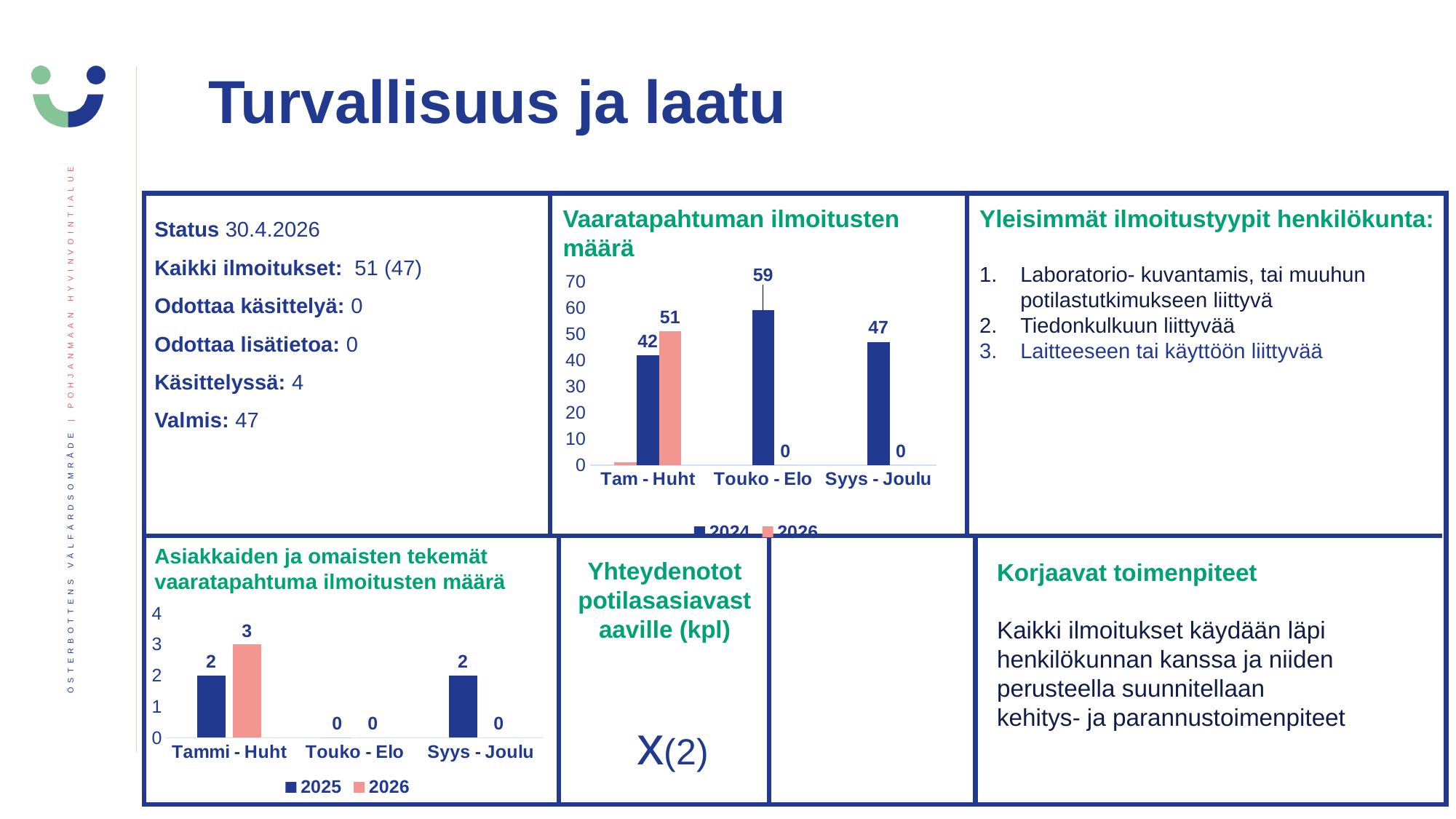
How many series does the legend of the chart 'Asiakkaiden ja omaisten tekemät vaaratapahtuma ilmoitusten määrä' list? 2 In the chart 'Asiakkaiden ja omaisten tekemät vaaratapahtuma ilmoitusten määrä', what is the 2025 value for Syys - Joulu? 2 What kind of chart is 'Vaaratapahtuman ilmoitusten määrä'? Bar chart In the chart 'Vaaratapahtuman ilmoitusten määrä', how many categories are shown on the x axis? 3 In the chart 'Vaaratapahtuman ilmoitusten määrä', what is the difference between the 2024 values for Touko - Elo and Syys - Joulu? 12 In the chart 'Vaaratapahtuman ilmoitusten määrä', what is the 2024 value for Touko - Elo? 59 In the chart 'Vaaratapahtuman ilmoitusten määrä', which category has the lowest 2024 value? Tam - Huht In the chart 'Vaaratapahtuman ilmoitusten määrä', which category has the highest 2024 value? Touko - Elo In the chart 'Vaaratapahtuman ilmoitusten määrä', for Tam - Huht, which is larger: the 2024 value or the 2026 value? 2026 In the chart 'Asiakkaiden ja omaisten tekemät vaaratapahtuma ilmoitusten määrä', what is the difference between the 2026 and 2025 values for Tammi - Huht? 1 In the chart 'Asiakkaiden ja omaisten tekemät vaaratapahtuma ilmoitusten määrä', what is the 2026 value for Tammi - Huht? 3 In the chart 'Vaaratapahtuman ilmoitusten määrä', what is the 2026 value for Tam - Huht? 51